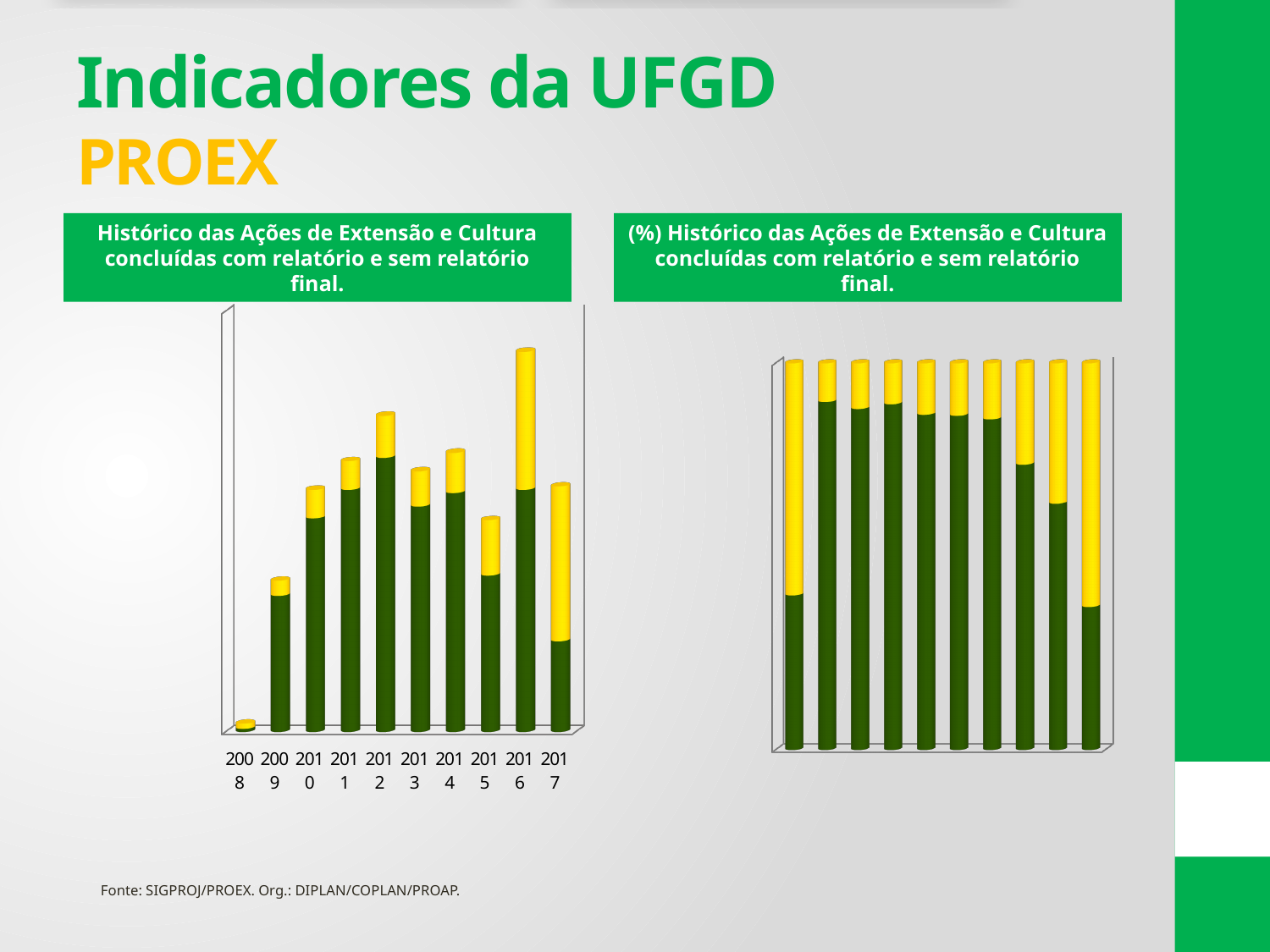
In the left chart, which year has the taller total bar, 2016 or 2017? 2016 In the left chart, which year has the taller total bar, 2012 or 2013? 2012 How many bars are plotted in the right chart? 10 What two colours are used for the stacked segments in the charts? Green and yellow In the left chart, which year has the shortest total bar? 2008 In the left chart, how many years are shown on the x axis? 10 What kind of chart is the left chart, 'Histórico das Ações de Extensão e Cultura concluídas com relatório e sem relatório final'? Stacked bar chart In the left chart, what is the first year shown on the x axis? 2008 In the left chart, which year has the taller total bar, 2009 or 2010? 2010 In the left chart, which year has the tallest total bar? 2016 In the left chart, what is the last year shown on the x axis? 2017 What kind of chart is the right chart, '(%) Histórico das Ações de Extensão e Cultura concluídas com relatório e sem relatório final'? Stacked bar chart